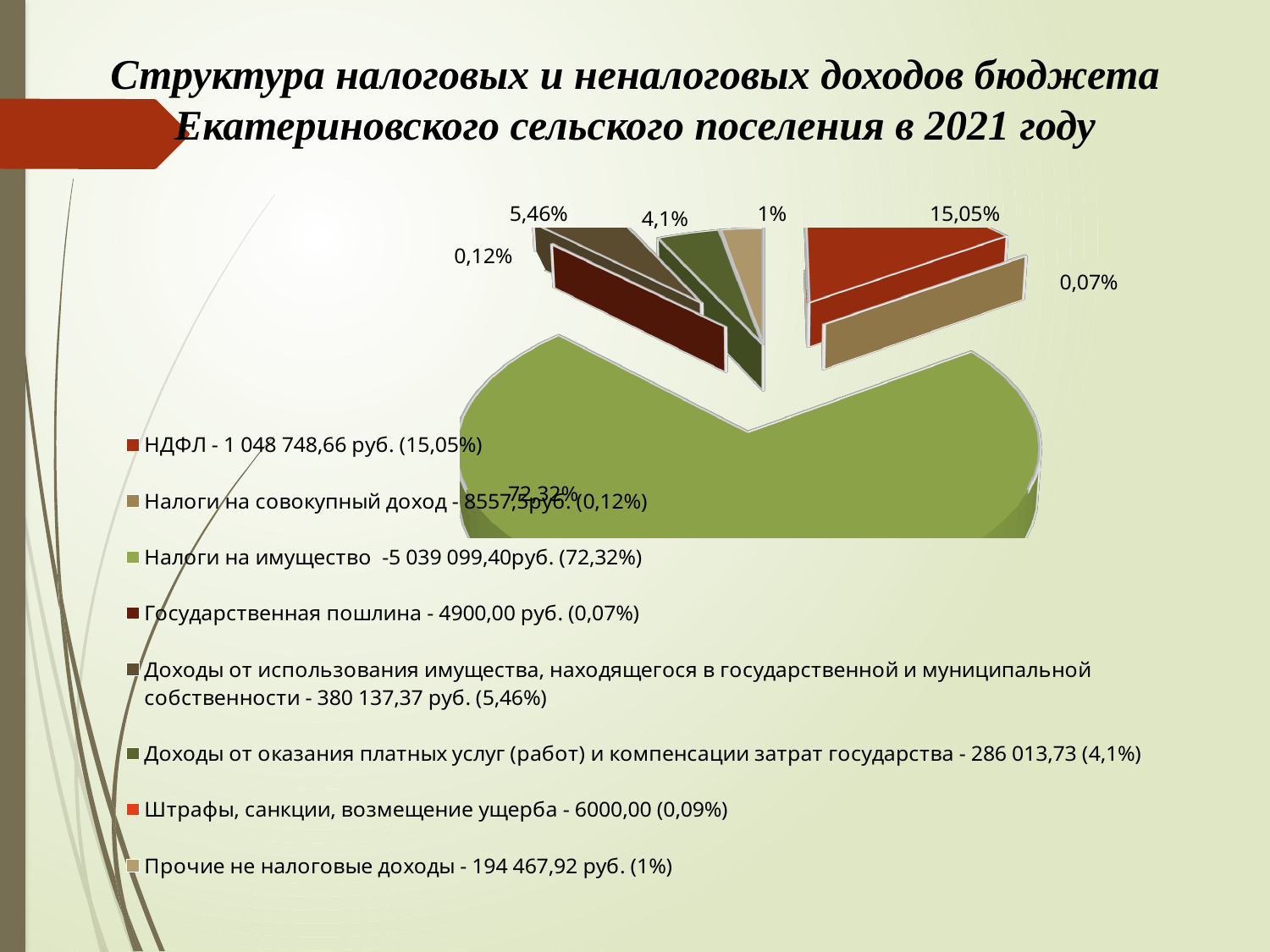
Which has a larger share: "НДФЛ" or "Доходы от оказания платных услуг (работ) и компенсации затрат государства"? НДФЛ What is the amount shown in the legend for "Доходы от использования имущества, находящегося в государственной и муниципальной собственности"? 380 137,37 руб. What percentage is shown in the legend for "Штрафы, санкции, возмещение ущерба"? 0,09% What year does the chart title refer to? 2021 What is the difference in percentage points between the share of "Налоги на имущество" (72,32%) and "НДФЛ" (15,05%)? 57,27 What share of the pie does "Налоги на имущество" account for? 72,32% What is the amount shown in the legend for "Прочие не налоговые доходы"? 194 467,92 руб. Which category has the largest share of the pie? Налоги на имущество What kind of chart is shown on the slide? pie chart How many entries does the chart legend list? 8 What share of the pie does "НДФЛ" account for? 15,05% Which category has the smallest share according to the legend? Государственная пошлина